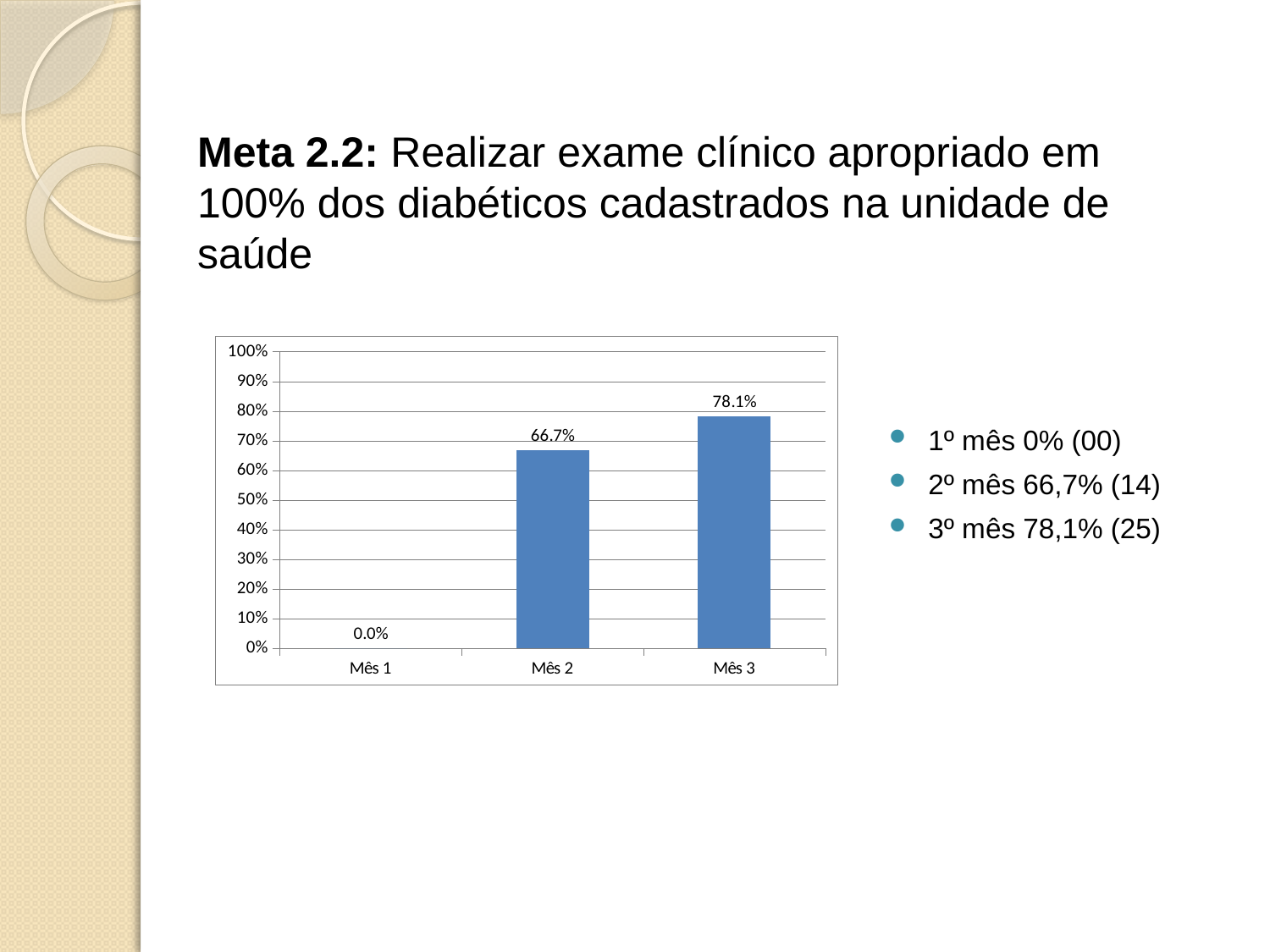
Is the value for Mês 3 greater or less than 70%? greater Which is larger, the value for Mês 2 or the value for Mês 3? Mês 3 Which month has the lowest value? Mês 1 What is the value for Mês 3? 78.1% How many categories are shown on the x axis? 3 What kind of chart is shown on the slide? bar chart What is the value for Mês 1? 0.0% Do the values rise or fall from Mês 1 to Mês 3? rise What is the value for Mês 2? 66.7% What is the difference between the values for Mês 3 and Mês 2? 11.4% Is the value for Mês 2 greater or less than 70%? less Which month has the highest value? Mês 3